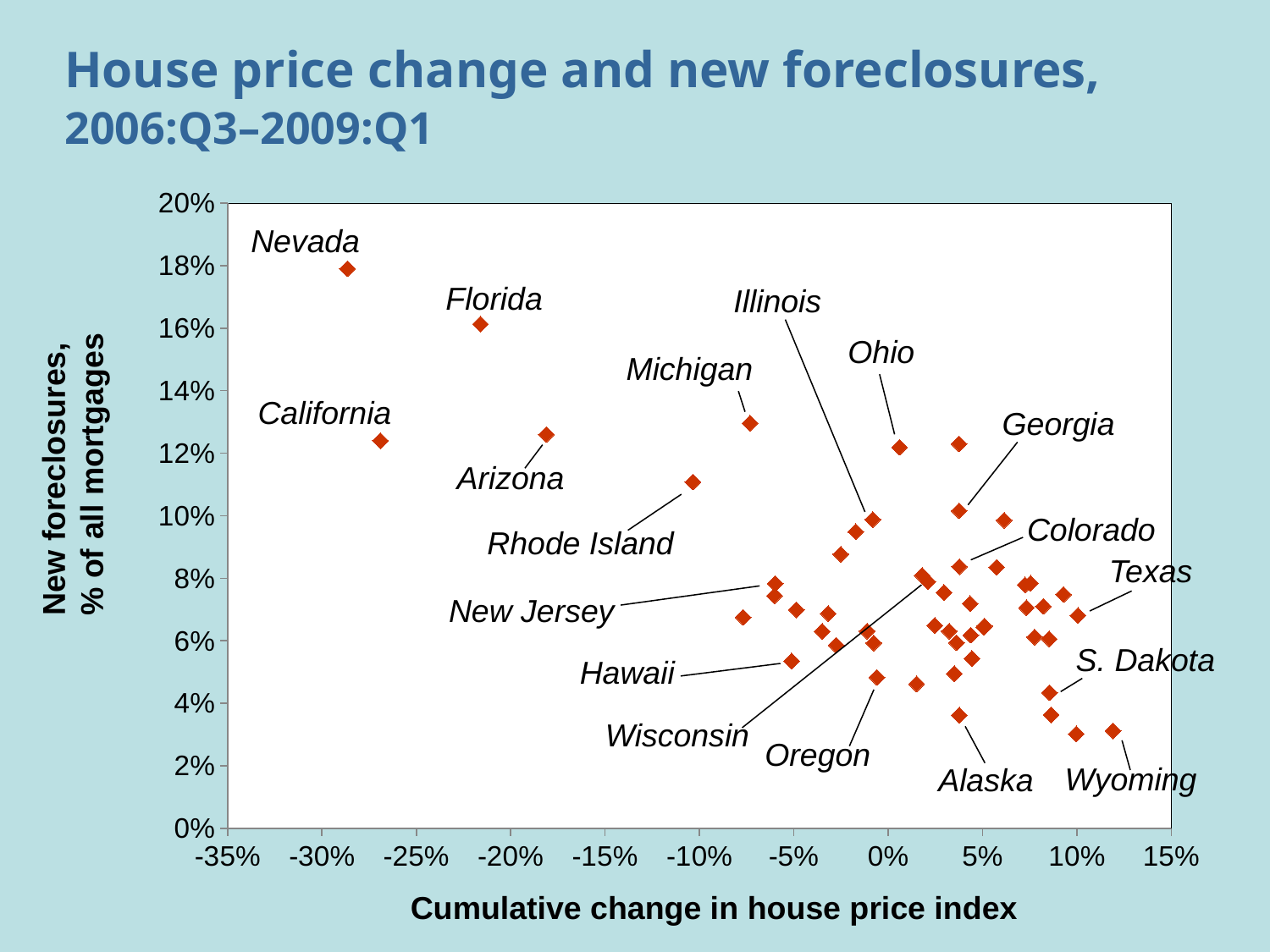
Is the new foreclosure rate for Wyoming greater or less than 4%? less Which has a higher new foreclosure rate, Florida or California? Florida Is the new foreclosure rate for Ohio greater or less than 10%? greater What is the label of the x axis? Cumulative change in house price index Is the cumulative change in house price index for Wyoming greater or less than 10%? greater Which has a higher new foreclosure rate, Texas or Wyoming? Texas Which labeled state has the highest new foreclosure rate? Nevada What kind of chart is shown on the slide? Scatter chart As the cumulative change in house price index increases along the x axis, do new foreclosure rates generally rise or fall? fall